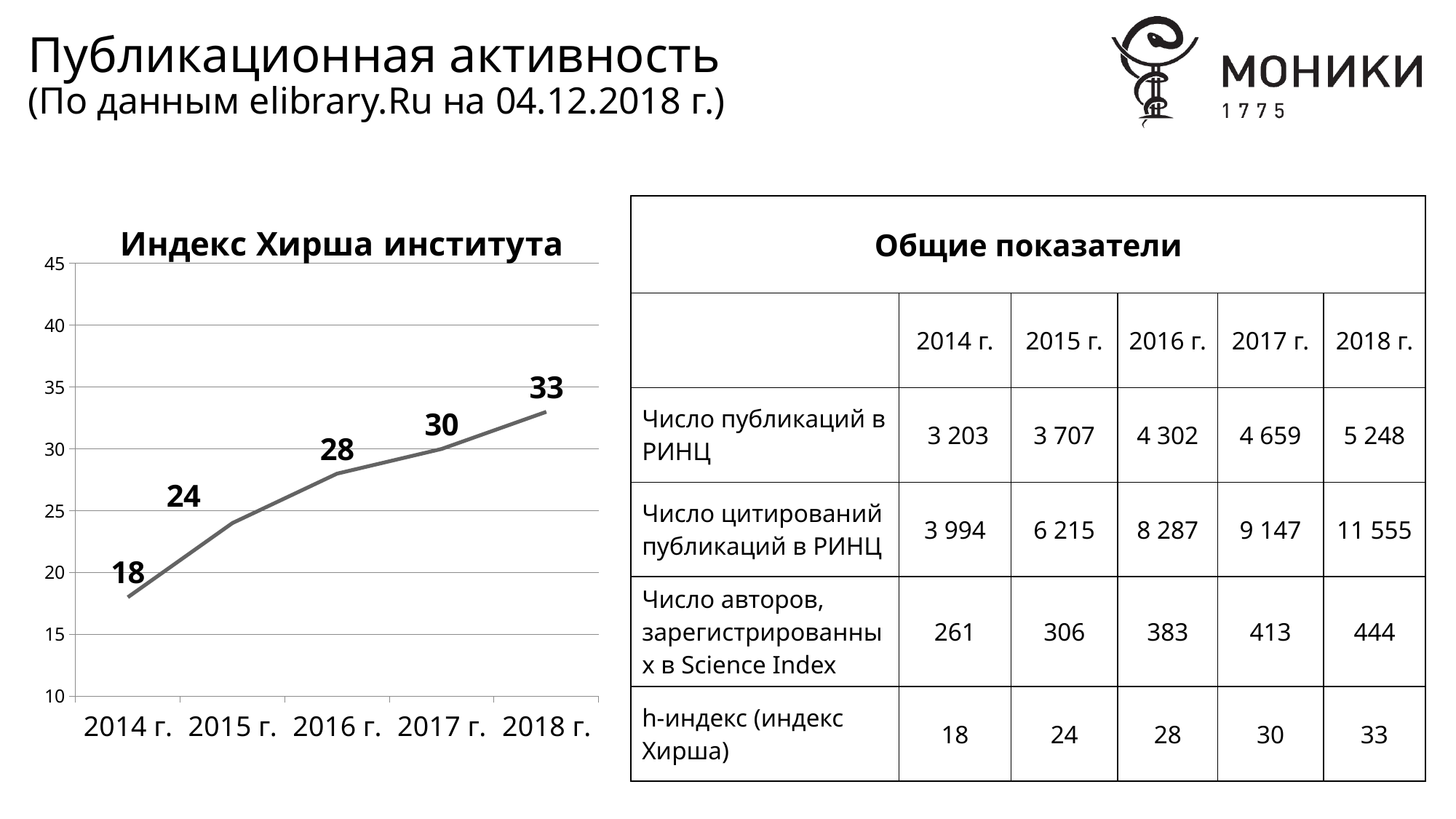
What type of chart is used to show the Hirsch index of the institute? line chart What is the value of the Hirsch index for 2014 г. in the chart? 18 How many years are plotted in the Hirsch index chart? 5 Does the Hirsch index rise or fall from 2014 г. to 2018 г.? rises Which year has the highest Hirsch index in the chart? 2018 г. What is the value of the Hirsch index (Индекс Хирша института) for 2016 г.? 28 What is the title of the chart on the left of the slide? Индекс Хирша института What is the difference between the Hirsch index values for 2017 г. and 2016 г.? 2 Is the Hirsch index for 2018 г. greater or less than 35? less Which year has the lowest Hirsch index in the chart? 2014 г. Which year has a higher Hirsch index, 2015 г. or 2017 г.? 2017 г. By how much did the Hirsch index increase from 2014 г. to 2018 г. according to the chart? 15